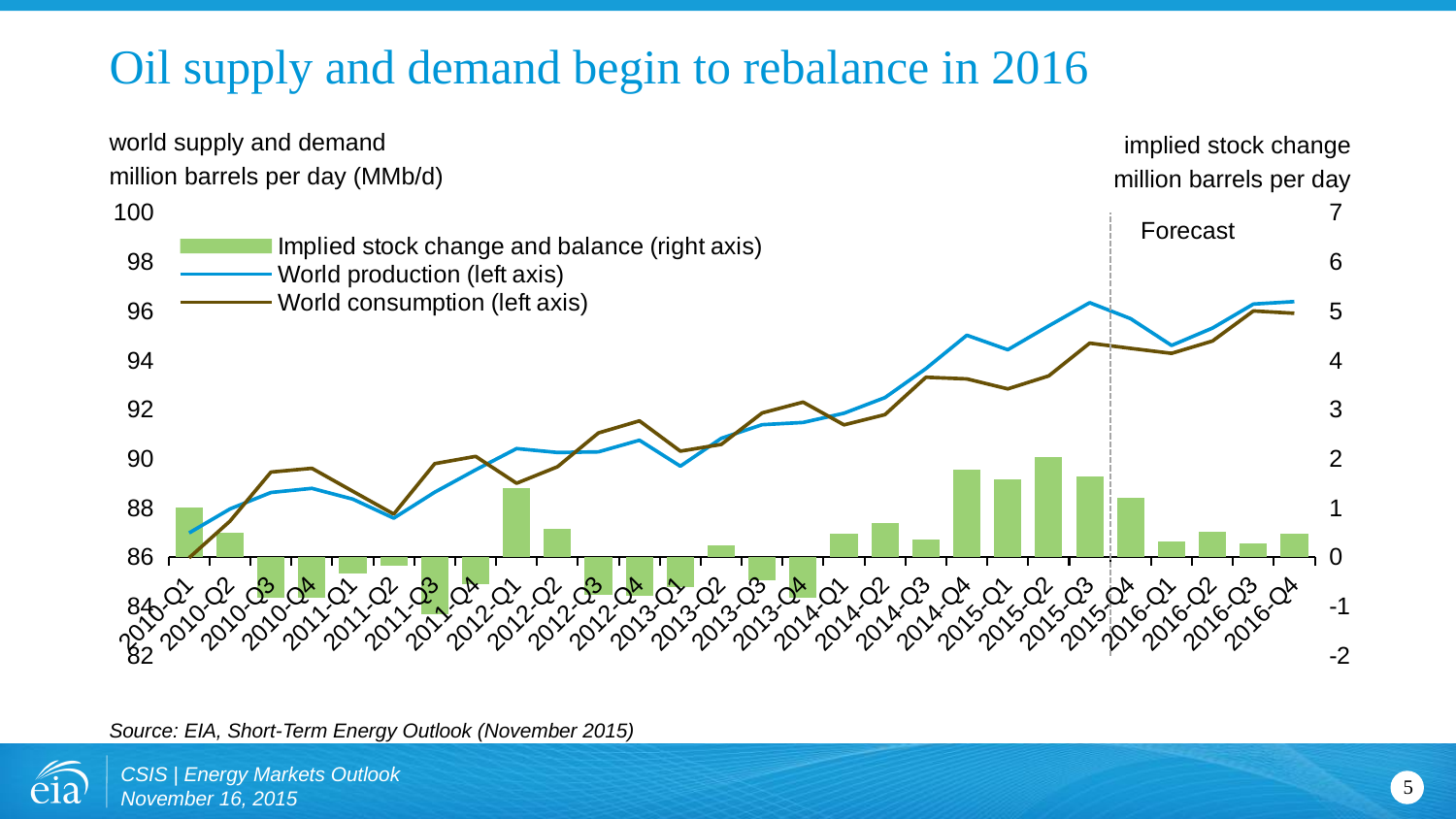
What type of chart is shown on the slide? Combined bar and line chart Is world production in 2010-Q1 greater or less than 88 MMb/d? less How many quarters are shown along the x axis? 28 Is the implied stock change for 2013-Q1 greater or less than 0? less What is the title of the slide? Oil supply and demand begin to rebalance in 2016 Is world consumption in 2016-Q4 greater or less than 94 MMb/d? greater In 2015-Q2, which is higher: world production or world consumption? World production Does world production generally rise or fall from 2010-Q1 to 2016-Q4? Rise Which quarter has the highest implied stock change bar? 2015-Q2 In 2010-Q3, which is higher: world production or world consumption? World consumption How many series does the legend list? 3